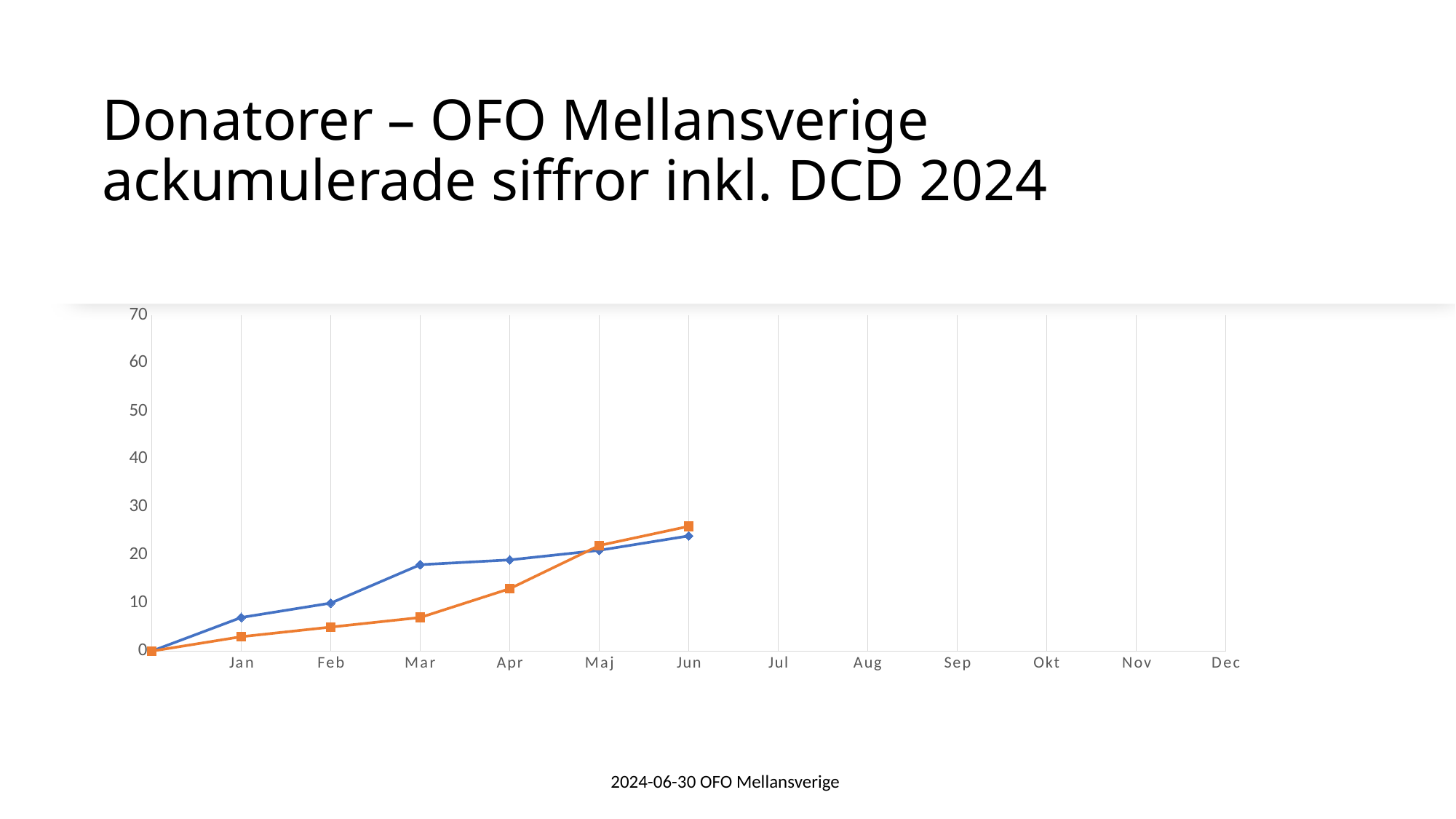
What is the highest value shown on the y axis of the chart? 70 How many months are labelled on the x axis of the chart? 12 At Jun, which line has the higher value, the blue line or the orange line? the orange line Is the value of the blue line at Jun greater or less than 20? greater Do the values of the blue line rise or fall from Jan to Jun? rise What kind of chart is shown on the slide? line chart Is the value of the orange line at Jan greater or less than 10? less Is the value of the blue line at Mar greater or less than 10? greater What is the last month for which the lines have plotted points? Jun At Mar, which line has the higher value, the blue line or the orange line? the blue line